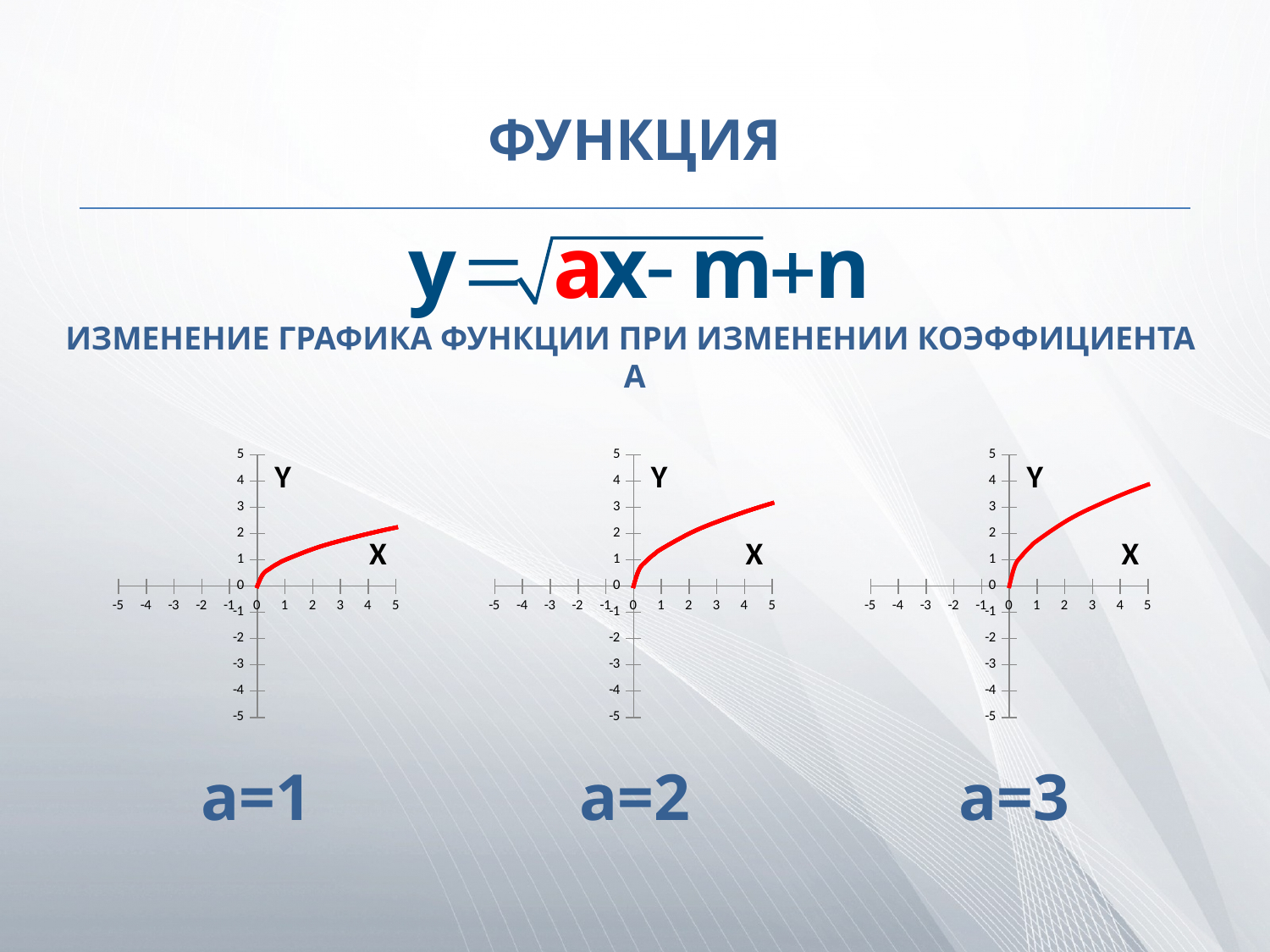
In the chart for a=2, is the value of y at x=1 greater or less than 2? less What kind of chart is shown for a=1? line chart How many charts are shown on the slide? 3 In the chart for a=2, what is the value of y at x=0? 0 What is the highest value shown on the Y axis of the chart for a=1? 5 At x=5, is the y value larger in the chart for a=1 or in the chart for a=3? a=3 What colour is the plotted curve in each chart? red In the chart for a=1, does the curve rise or fall as x increases? rise In the chart for a=3, is the value of y at x=5 greater or less than 3? greater In the chart for a=1, is the value of y at x=5 greater or less than 3? less Which chart's curve reaches the highest y value at x=5: a=1, a=2 or a=3? a=3 In the chart for a=3, does the curve rise or fall as x increases? rise